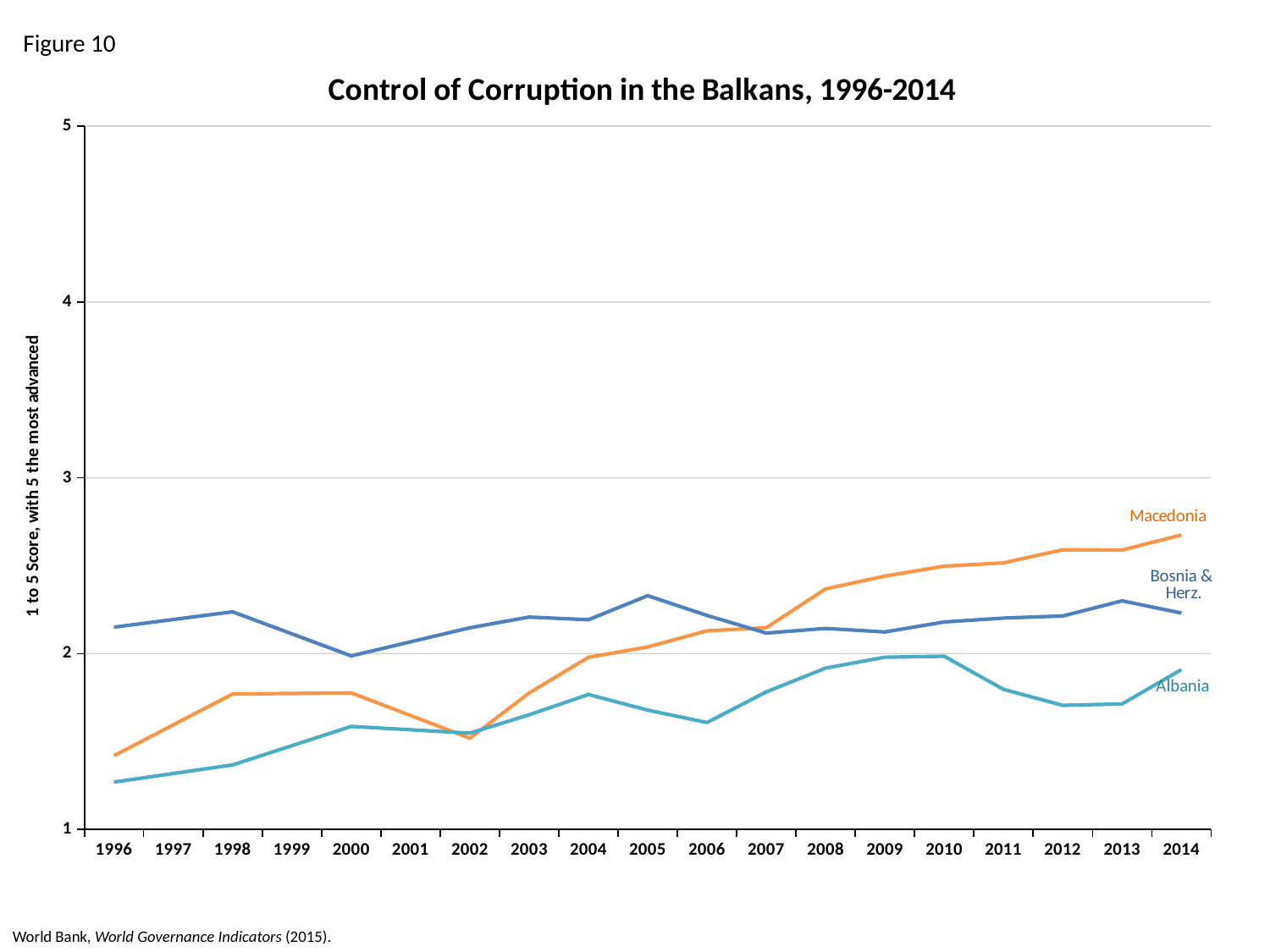
Is the value for Albania in 1996 greater or less than 1.5? less Which country has the highest Control of Corruption score in 2014? Macedonia Is the value for Macedonia in 1996 greater or less than 2? less Is the value for Macedonia in 2014 greater or less than 2.5? greater Does Macedonia's score generally rise or fall from 1996 to 2014? Rise What kind of chart is shown on the slide? Line chart In 2005, which is larger: the score for Bosnia & Herz. or the score for Macedonia? Bosnia & Herz. Which country has the lowest Control of Corruption score in 2014? Albania How many years are shown along the x axis? 19 How many countries (series) are plotted on the chart? 3 Which country has the highest score in 1996? Bosnia & Herz. What is the title of the chart? Control of Corruption in the Balkans, 1996-2014